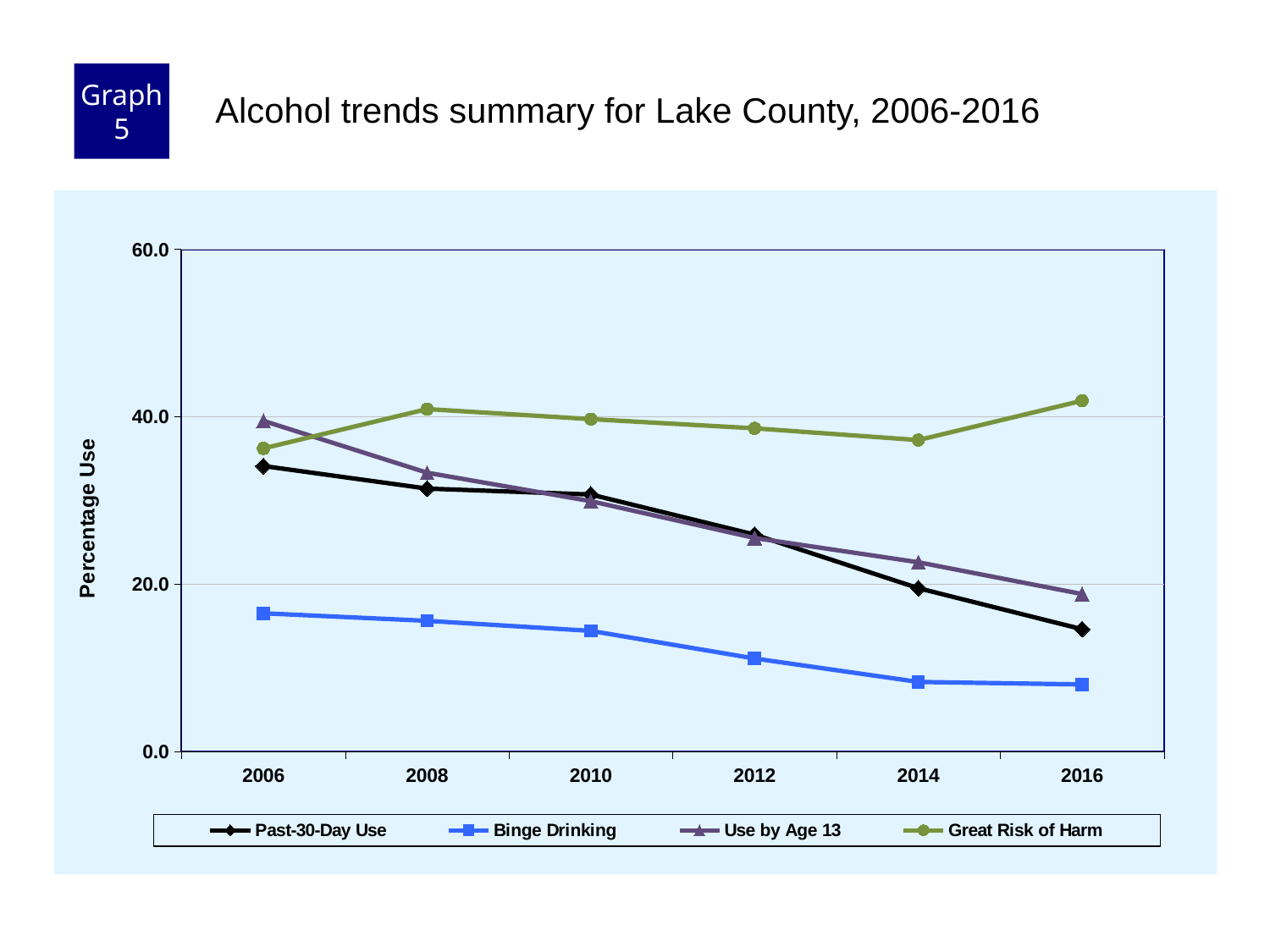
How many years are plotted along the x axis? 6 Does the Binge Drinking line rise or fall from 2006 to 2016? Falls Is the value for Great Risk of Harm in 2016 greater or less than 40.0? greater In 2016, which is higher: Past-30-Day Use or Use by Age 13? Use by Age 13 Is the value for Binge Drinking in 2006 greater or less than 20.0? less In 2006, which is higher: Use by Age 13 or Past-30-Day Use? Use by Age 13 Which series has the lowest value in 2006? Binge Drinking What kind of chart is shown on the slide? Line chart Does the Past-30-Day Use line rise or fall from 2006 to 2016? Falls Which series has the highest value in 2016? Great Risk of Harm How many series does the legend list? 4 What is the label on the y axis? Percentage Use